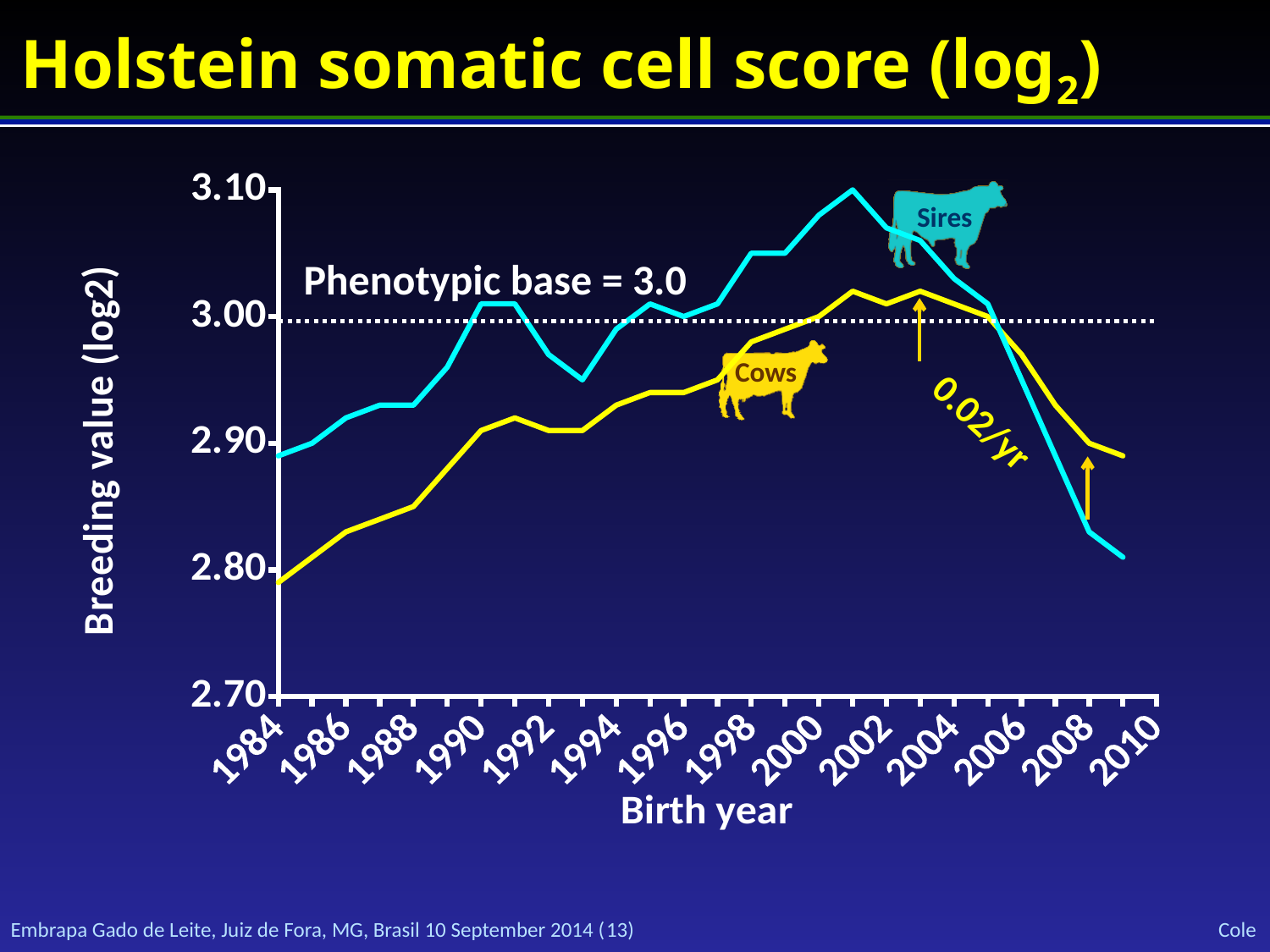
Does the Cows line rise or fall between 1984 and 2002? rise Is the value for Sires in 2002 greater or less than 3.00? greater What is the title of the x axis? Birth year Which series reaches the highest breeding value on the chart? Sires What kind of chart is shown on the slide? line chart What value is the phenotypic base shown by the dotted line? 3.0 Does the Sires line rise or fall between 2004 and 2010? fall In 1990, which series has the higher breeding value, Sires or Cows? Sires How many series are plotted on the chart? 2 In 2000, which series has the higher breeding value, Sires or Cows? Sires Is the value for Cows in 1986 greater or less than 2.80? greater